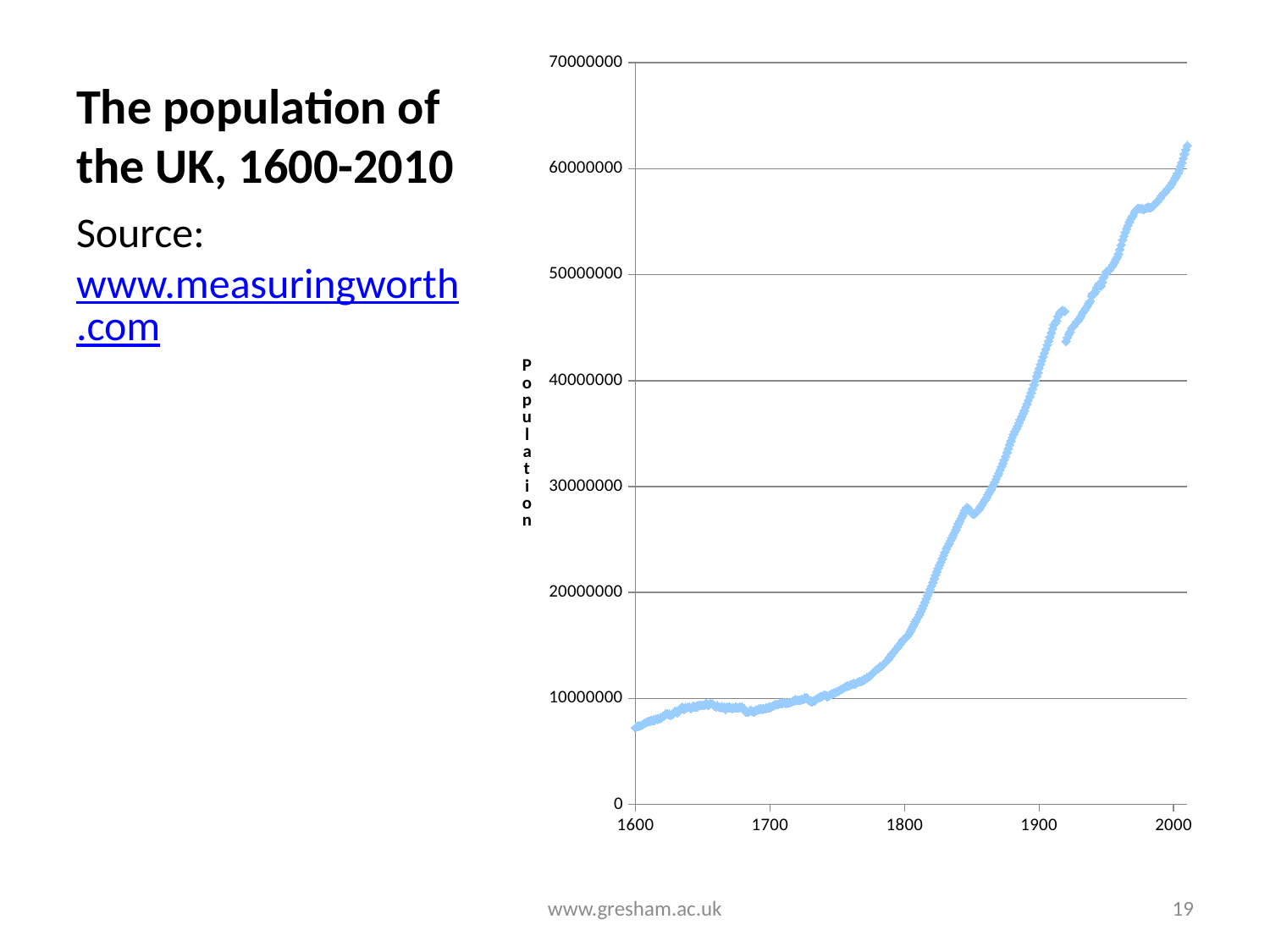
Is the population value at 2000 greater or less than 50000000? greater Is the population value at 1900 greater or less than 30000000? greater Does the UK population generally rise or fall from 1600 to 2010 along the x axis? rise Which is larger, the population in 1800 or the population in 1700? 1800 Around which end of the time range is the population at its highest? 2010 Is the population value at 1800 greater or less than 10000000? greater Around which year is the population at its lowest? 1600 What kind of chart is shown on the slide? scatter chart What is the label on the vertical axis of the chart? Population What is the highest value shown on the vertical axis? 70000000